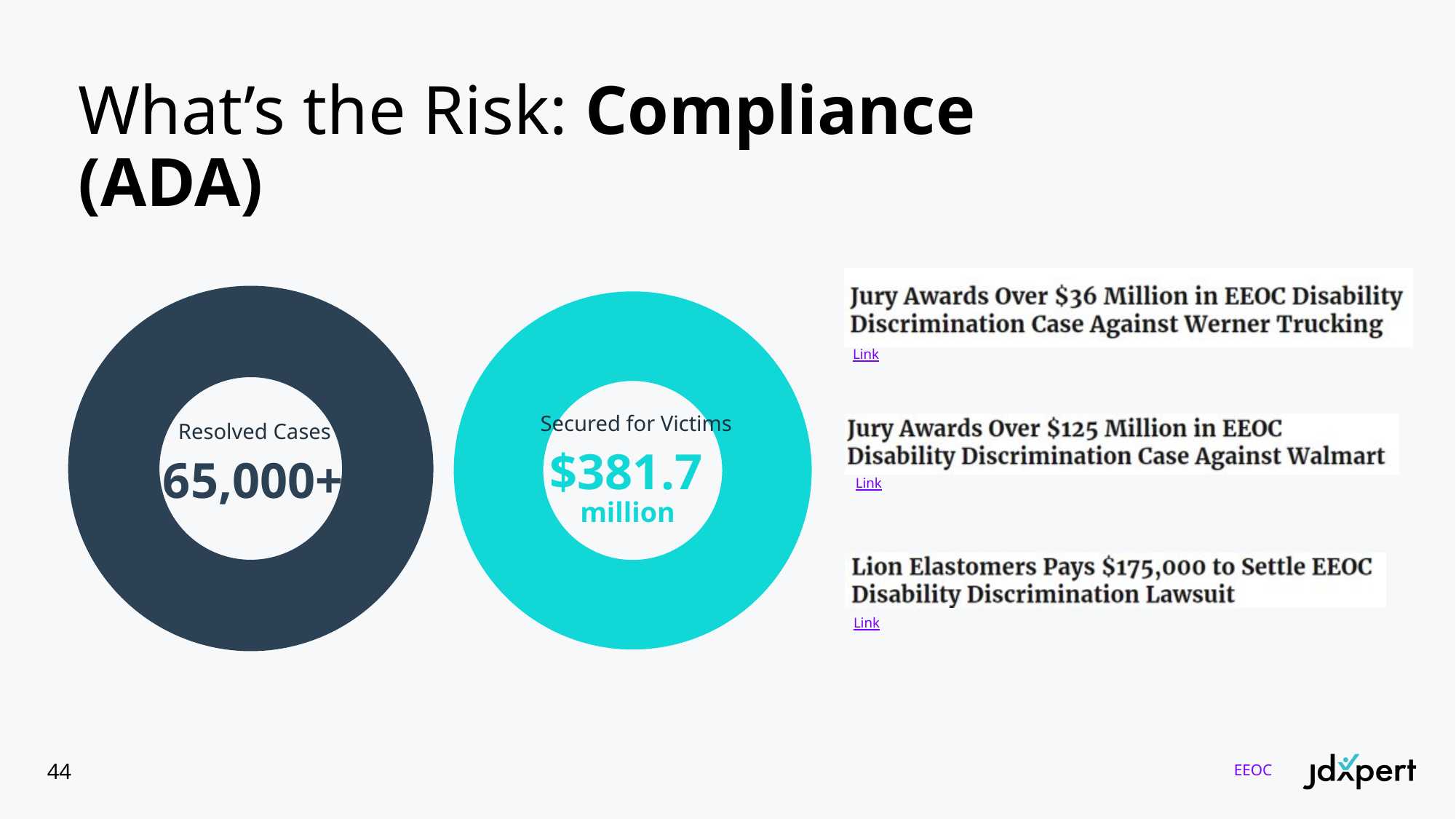
What label appears inside the right (teal) donut chart? Secured for Victims How many donut charts are shown on the slide? 2 What kind of chart is used to display the Resolved Cases figure? Donut chart In the right donut chart, what amount is shown as Secured for Victims? $381.7 million What label appears inside the left (dark) donut chart? Resolved Cases Which donut chart shows a dollar amount, the left one or the right one? The right one In the left donut chart, what value is shown for Resolved Cases? 65,000+ Which donut chart displays the figure 65,000+, the left one or the right one? The left one